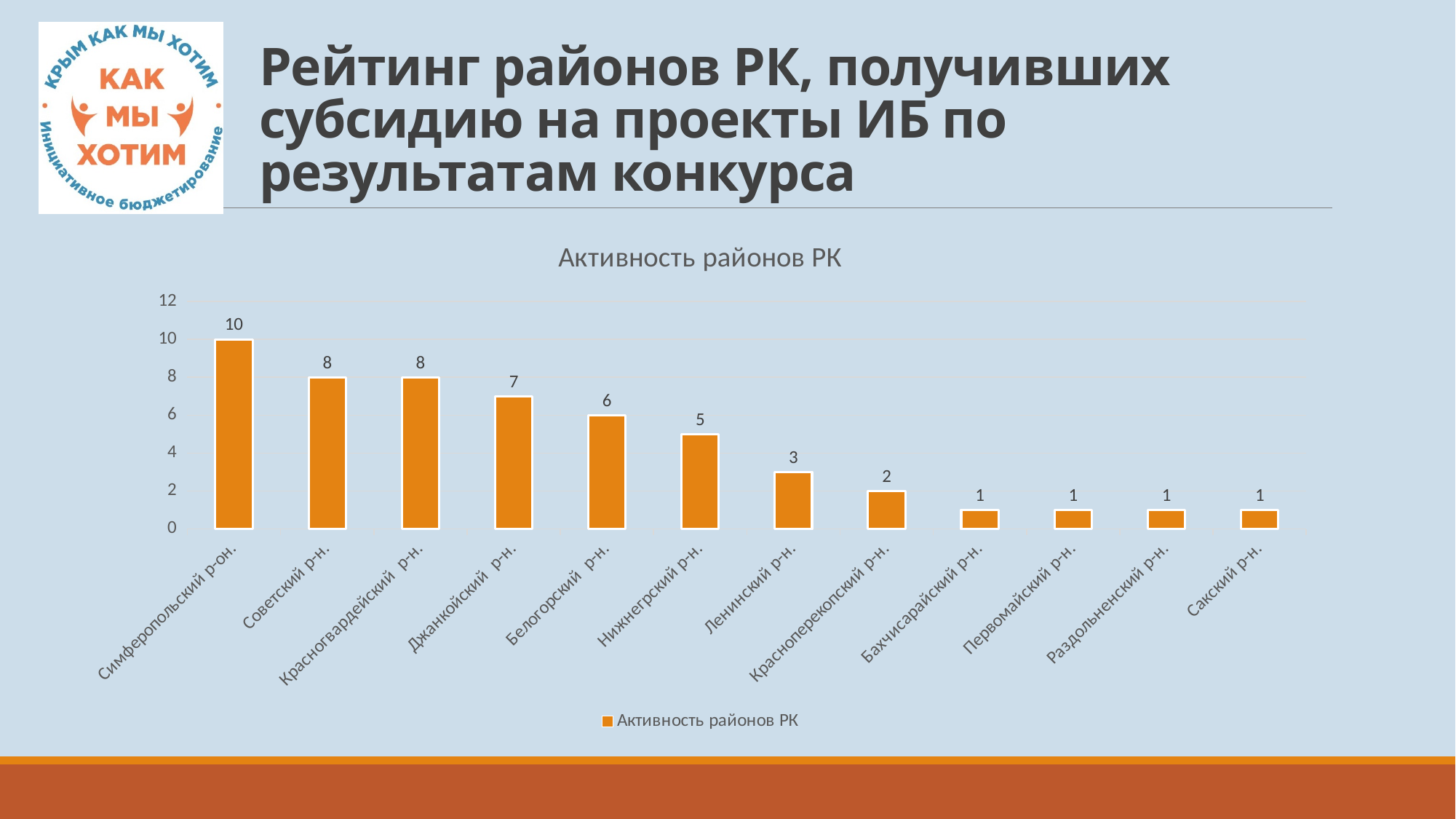
How many series does the legend list? 1 What is the difference between the values for Симферопольский р-он. and Джанкойский р-н.? 3 Do the values rise or fall from left to right along the x axis? fall What is the value for Нижнегорский р-н.? 5 Which is larger, the value for Советский р-н. or the value for Нижнегорский р-н.? Советский р-н. What kind of chart is shown? bar chart What is the difference between the values for Белогорский р-н. and Ленинский р-н.? 3 What is the title of the chart? Активность районов РК Which category has the highest value? Симферопольский р-он. What is the value for Красноперекопский р-н.? 2 What is the value for Симферопольский р-он.? 10 How many categories are shown on the x axis? 12